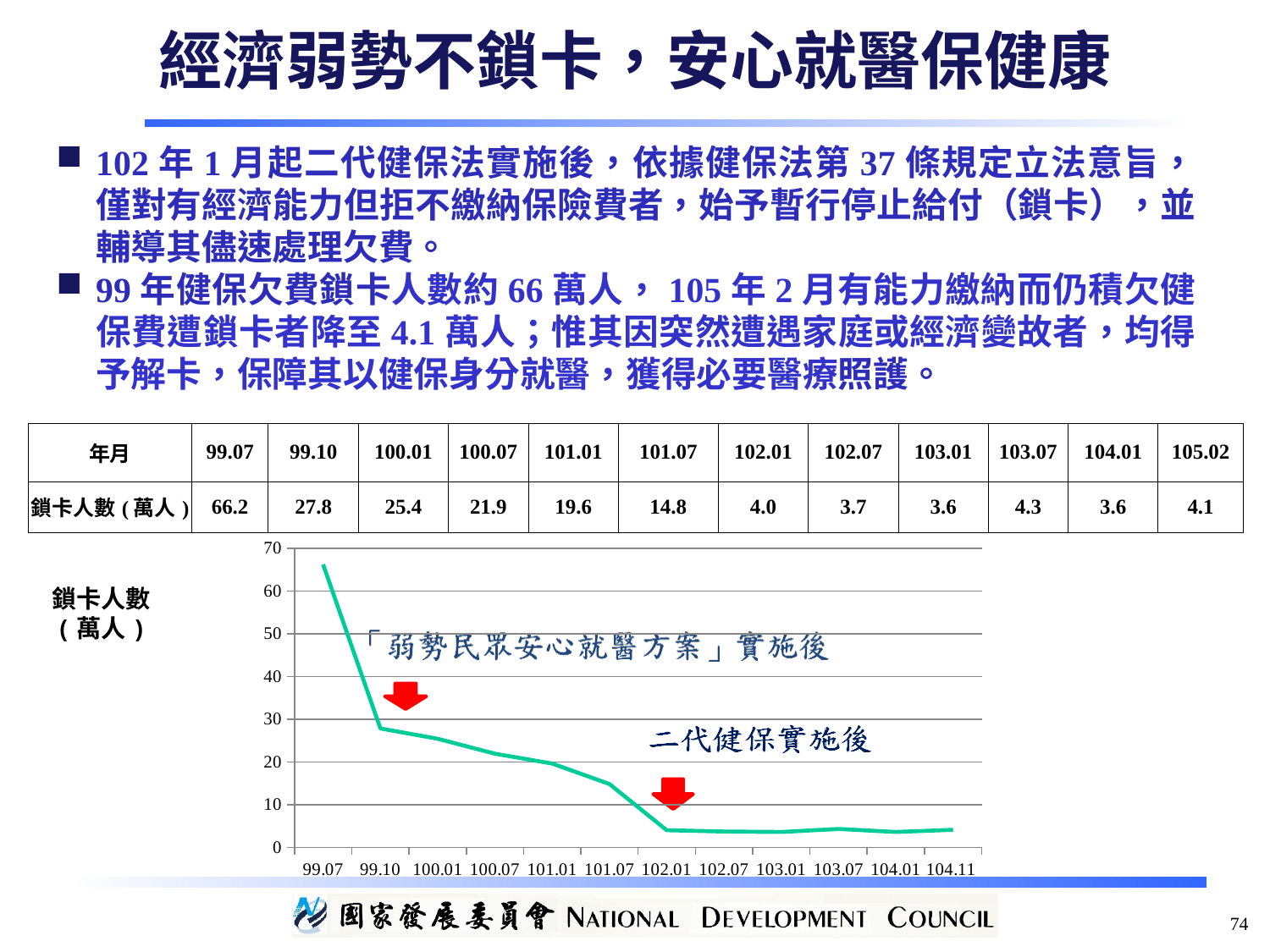
Which is larger, the 鎖卡人數 for 100.07 or for 101.01? 100.07 What is the difference in 鎖卡人數 (萬人) between 99.07 and 99.10? 38.4 What is the 鎖卡人數 (萬人) value for 99.07? 66.2 Do the values rise or fall along the x axis from 99.07 to 102.01? fall What is the 鎖卡人數 (萬人) value for 101.07? 14.8 How many data points are plotted on the line chart? 12 What is the 鎖卡人數 (萬人) value for 102.01? 4.0 What is the lowest 鎖卡人數 (萬人) value shown? 3.6 What is the label on the y axis of the chart? 鎖卡人數（萬人） Is the value for 102.07 greater or less than 10? less Which period has the highest 鎖卡人數? 99.07 What kind of chart is shown on the slide? line chart